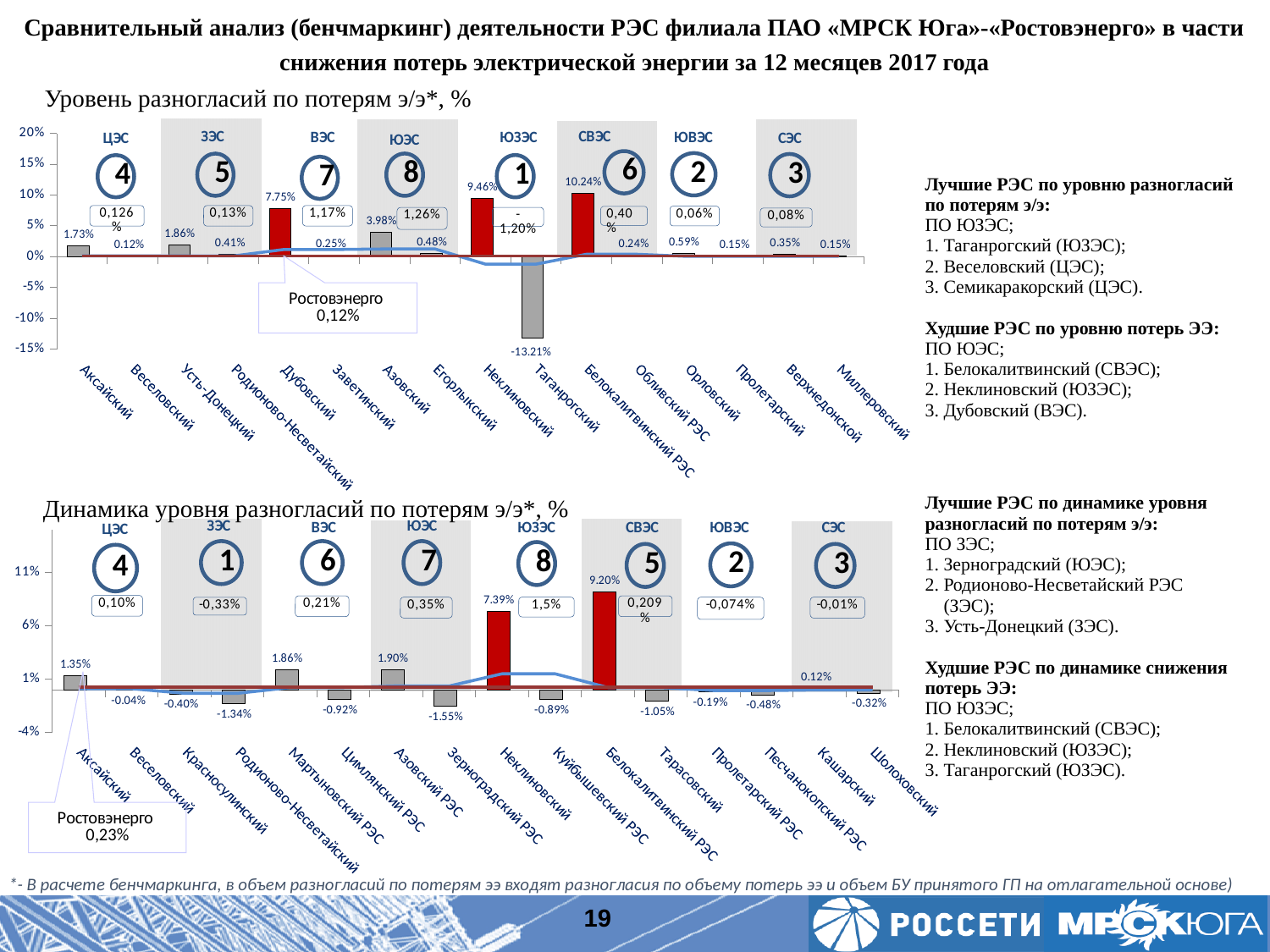
On the chart 'Динамика уровня разногласий по потерям э/э*, %', which category has the lowest value? Зерноградский РЭС On the chart 'Динамика уровня разногласий по потерям э/э*, %', what is the difference between the values for Белокалитвинский РЭС and Неклиновский? 1.81% On the chart 'Динамика уровня разногласий по потерям э/э*, %', what is the value for Неклиновский? 7.39% On the chart 'Уровень разногласий по потерям э/э*, %', which category has the lowest value? Таганрогский How many categories are plotted on the chart 'Уровень разногласий по потерям э/э*, %'? 16 What kind of chart is 'Динамика уровня разногласий по потерям э/э*, %'? Combination bar and line chart On the chart 'Динамика уровня разногласий по потерям э/э*, %', what value is shown in the callout for Ростовэнерго? 0,23% On the chart 'Уровень разногласий по потерям э/э*, %', which is larger: the value for Азовский or for Усть-Донецкий? Азовский On the chart 'Уровень разногласий по потерям э/э*, %', which category has the highest value? Белокалитвинский РЭС On the chart 'Уровень разногласий по потерям э/э*, %', what is the value for Таганрогский? -13.21% On the chart 'Уровень разногласий по потерям э/э*, %', what is the difference between the values for Белокалитвинский РЭС and Неклиновский? 0.78% On the chart 'Уровень разногласий по потерям э/э*, %', what is the value for Дубовский? 7.75%